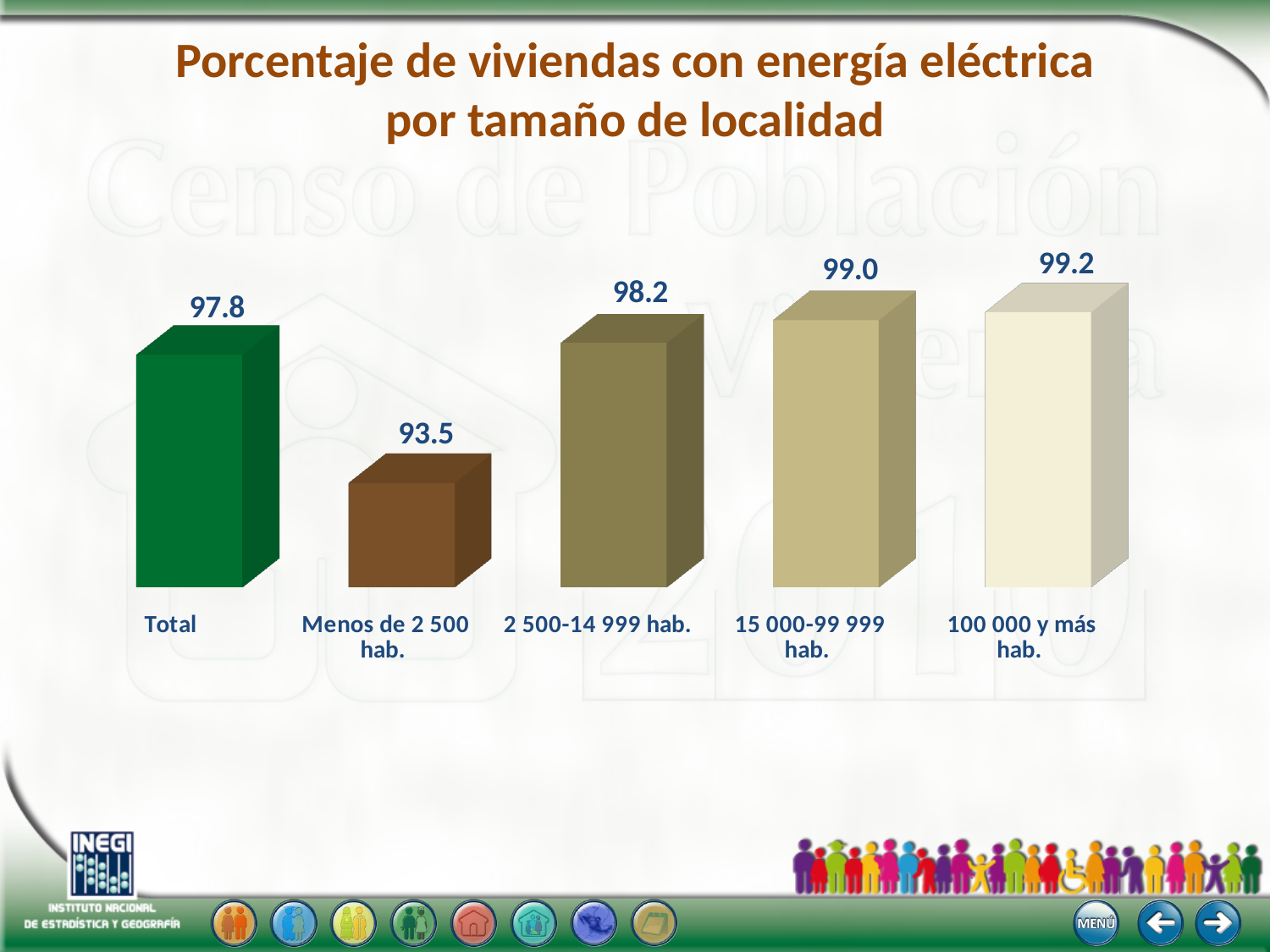
What is the title of the chart? Porcentaje de viviendas con energía eléctrica por tamaño de localidad Which is larger, the value for Total or the value for 2 500-14 999 hab.? 2 500-14 999 hab. What is the value for Menos de 2 500 hab.? 93.5 Which category has the lowest value? Menos de 2 500 hab. What kind of chart is shown on the slide? Bar chart How many categories are shown in the chart? 5 Which category has the highest value? 100 000 y más hab. What is the value for 2 500-14 999 hab.? 98.2 What is the difference between the values for 100 000 y más hab. and Menos de 2 500 hab.? 5.7 What is the value for 100 000 y más hab.? 99.2 What is the value for 15 000-99 999 hab.? 99.0 What is the value for Total? 97.8